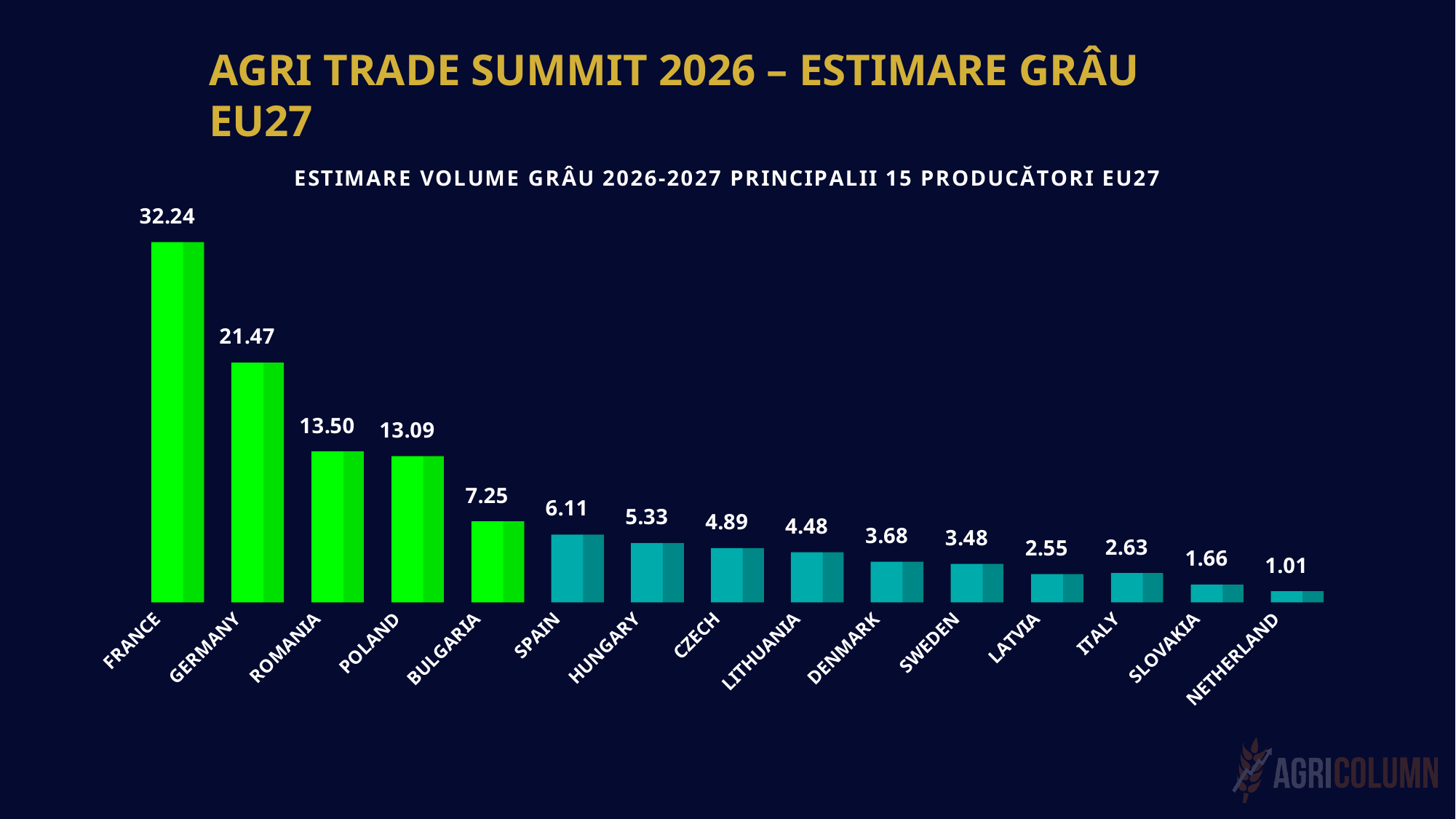
What kind of chart is shown on the slide? Bar chart What is the difference between the values for France and Germany? 10.77 What is the value shown for Slovakia? 1.66 What is the value shown for Romania? 13.50 Which country has the highest estimated wheat volume? France Which has a larger value, Spain or Hungary? Spain What is the estimated wheat volume for France? 32.24 Which has a larger value, Latvia or Italy? Italy How many countries are shown in the chart? 15 What is the title of the chart? ESTIMARE VOLUME GRÂU 2026-2027 PRINCIPALII 15 PRODUCĂTORI EU27 Which country has the lowest estimated wheat volume? Netherland What is the difference between the values for Romania and Poland? 0.41